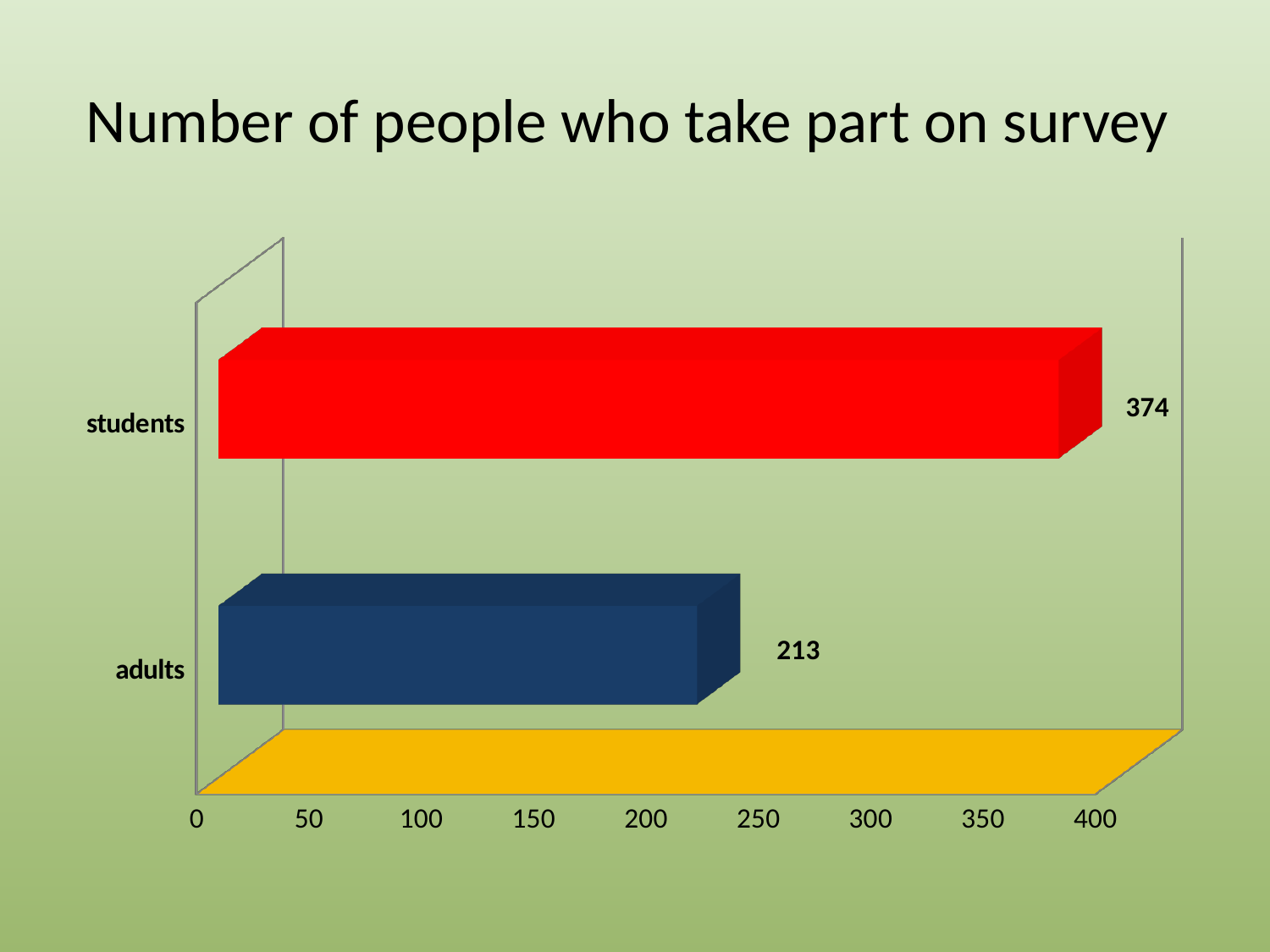
Which is larger, the value for students or the value for adults? students What colour is the bar for students? red How many categories are shown in the chart? 2 What is the title of the slide? Number of people who take part on survey What is the difference between the values for students and adults? 161 Which category has the lowest value? adults What kind of chart is shown on the slide? bar chart Is the value for students greater or less than 350? greater What is the value for students? 374 Is the value for adults greater or less than 250? less Which category has the highest value? students What is the value for adults? 213